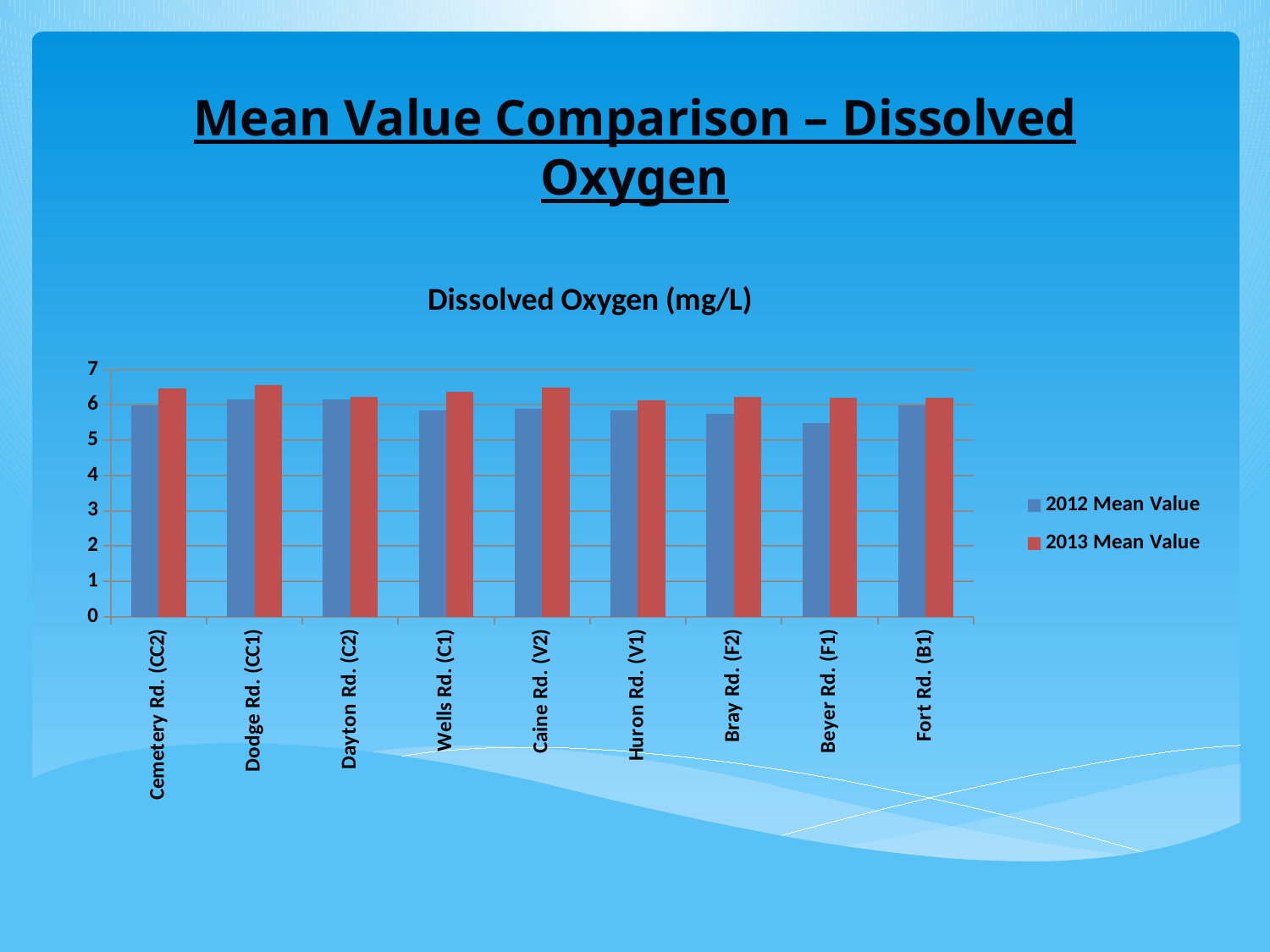
At Beyer Rd. (F1), which is larger: the 2012 Mean Value or the 2013 Mean Value? 2013 Mean Value How many series does the chart legend list? 2 Is the 2013 Mean Value for Cemetery Rd. (CC2) greater or less than 6? greater How many sampling sites (categories) are shown on the x axis of the chart? 9 What is the title shown above the chart's plot area? Dissolved Oxygen (mg/L) What kind of chart is shown on the slide? bar chart Is the 2013 Mean Value for Dodge Rd. (CC1) greater or less than 6? greater Which is larger: the 2012 Mean Value for Dodge Rd. (CC1) or the 2012 Mean Value for Beyer Rd. (F1)? Dodge Rd. (CC1) Is the 2012 Mean Value for Beyer Rd. (F1) greater or less than 6? less Which colour represents the 2013 Mean Value series in the chart? red Which site has the lowest 2012 Mean Value for dissolved oxygen? Beyer Rd. (F1)